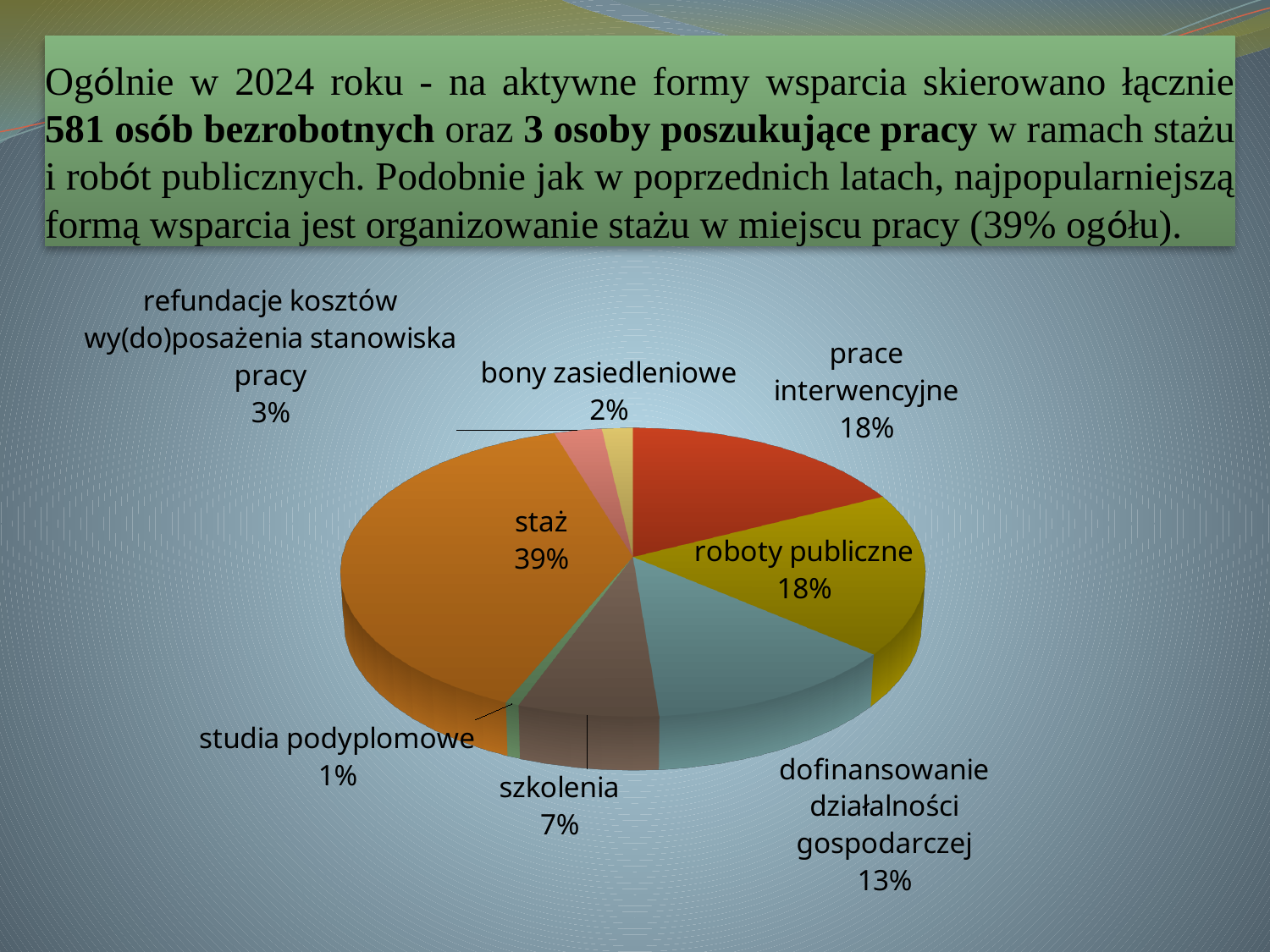
What percentage is shown for szkolenia? 7% What percentage is shown for roboty publiczne? 18% What percentage is shown for refundacje kosztów wy(do)posażenia stanowiska pracy? 3% Which is larger, the slice for szkolenia or the slice for dofinansowanie działalności gospodarczej? dofinansowanie działalności gospodarczej Which category has the smallest slice of the pie? studia podyplomowe How many categories (slices) does the pie chart show? 8 By how many percentage points does staż exceed prace interwencyjne? 21 percentage points What percentage is shown for dofinansowanie działalności gospodarczej? 13% What share of the pie does staż represent? 39% What type of chart is shown on the slide? Pie chart What percentage is shown for bony zasiedleniowe? 2% Which category has the largest slice of the pie? staż